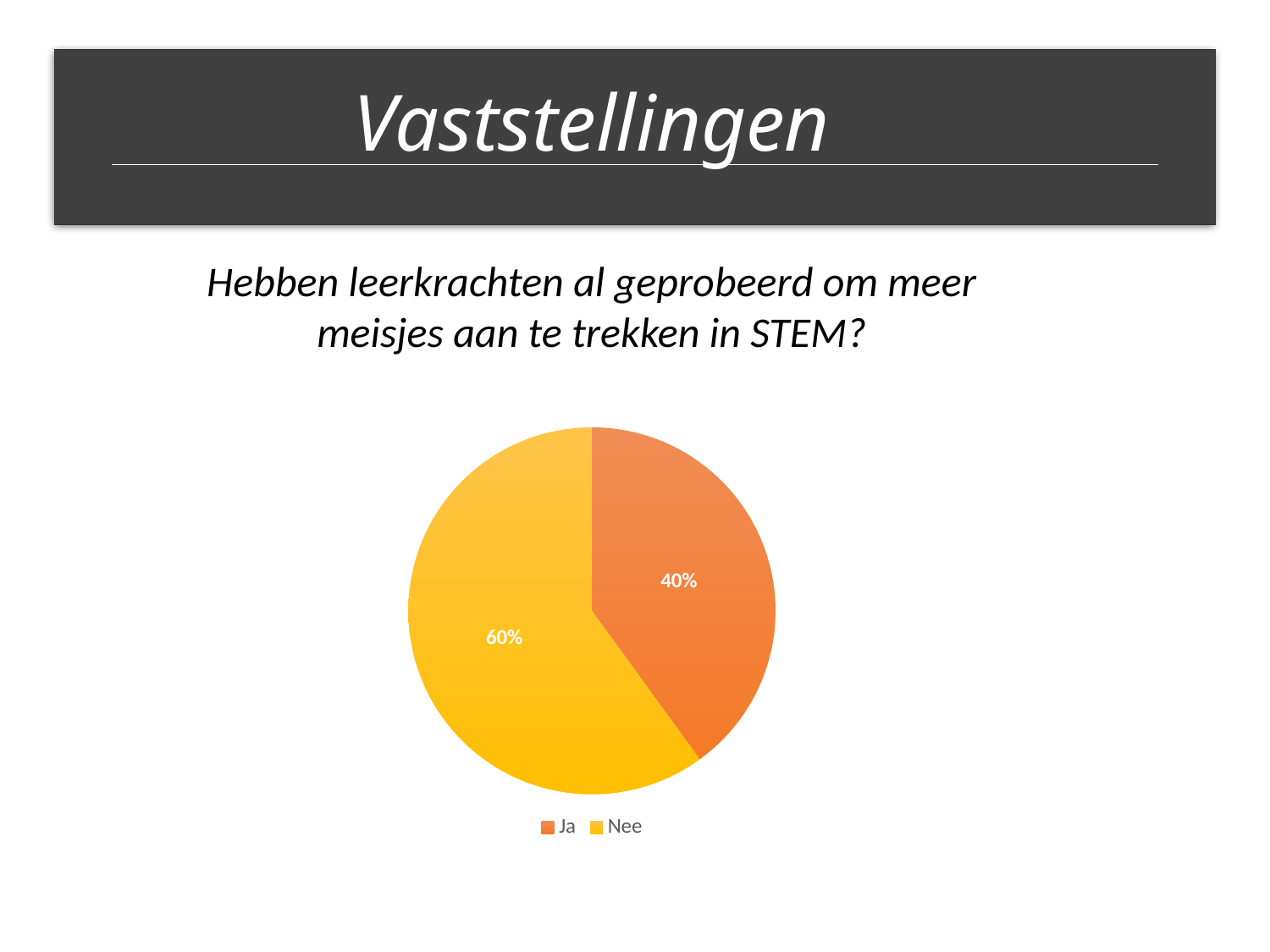
How many entries does the legend list? 2 Which slice is the largest in the pie chart? Nee What kind of chart is shown on the slide? pie chart How many slices does the pie chart have? 2 Which slice is the smallest in the pie chart? Ja What share of the pie does the "Ja" slice represent? 40% What is the difference in percentage points between the "Nee" and "Ja" slices? 20 What question is the pie chart answering, according to the text above it? Hebben leerkrachten al geprobeerd om meer meisjes aan te trekken in STEM? What share of the pie does the "Nee" slice represent? 60% What colour is the "Ja" slice in the pie chart? orange Which is larger, the "Ja" slice or the "Nee" slice? Nee